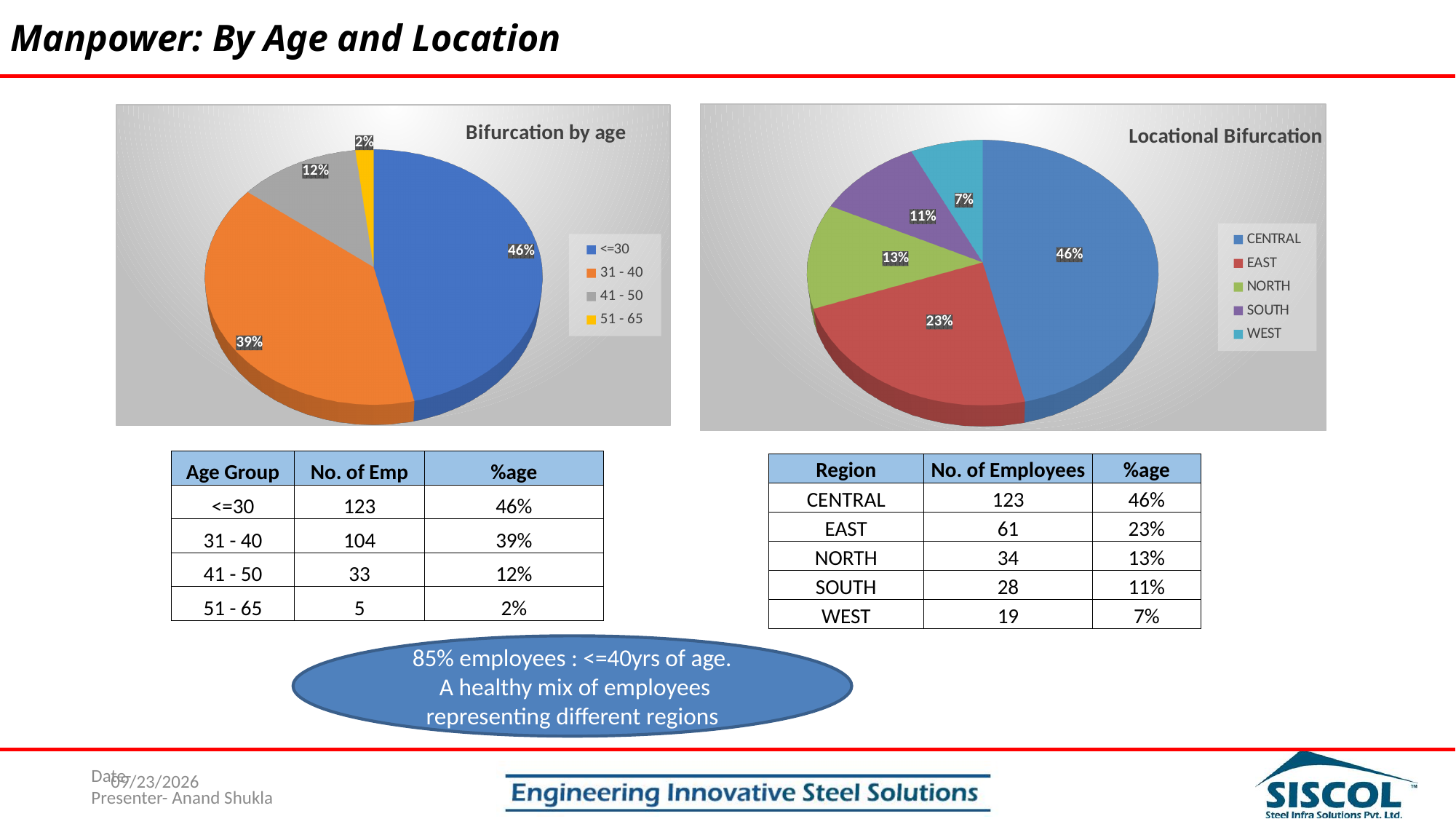
How many categories does the 'Bifurcation by age' chart show? 4 In the 'Locational Bifurcation' chart, which is larger, NORTH or SOUTH? NORTH In the 'Bifurcation by age' chart, what share of the pie does the <=30 slice represent? 46% In the 'Bifurcation by age' chart, what is the value shown for the 41 - 50 slice? 12% In the 'Locational Bifurcation' chart, what share of the pie does EAST represent? 23% In the 'Bifurcation by age' chart, which age group has the smallest slice? 51 - 65 In the 'Bifurcation by age' chart, what is the difference in percentage points between the <=30 and 31 - 40 slices? 7% In the 'Bifurcation by age' chart, which age group has the largest slice? <=30 How many regions does the legend of the 'Locational Bifurcation' chart list? 5 In the 'Locational Bifurcation' chart, which region has the smallest slice? WEST What type of chart is the 'Locational Bifurcation' chart? Pie chart In the 'Locational Bifurcation' chart, what colour is the CENTRAL slice? Blue